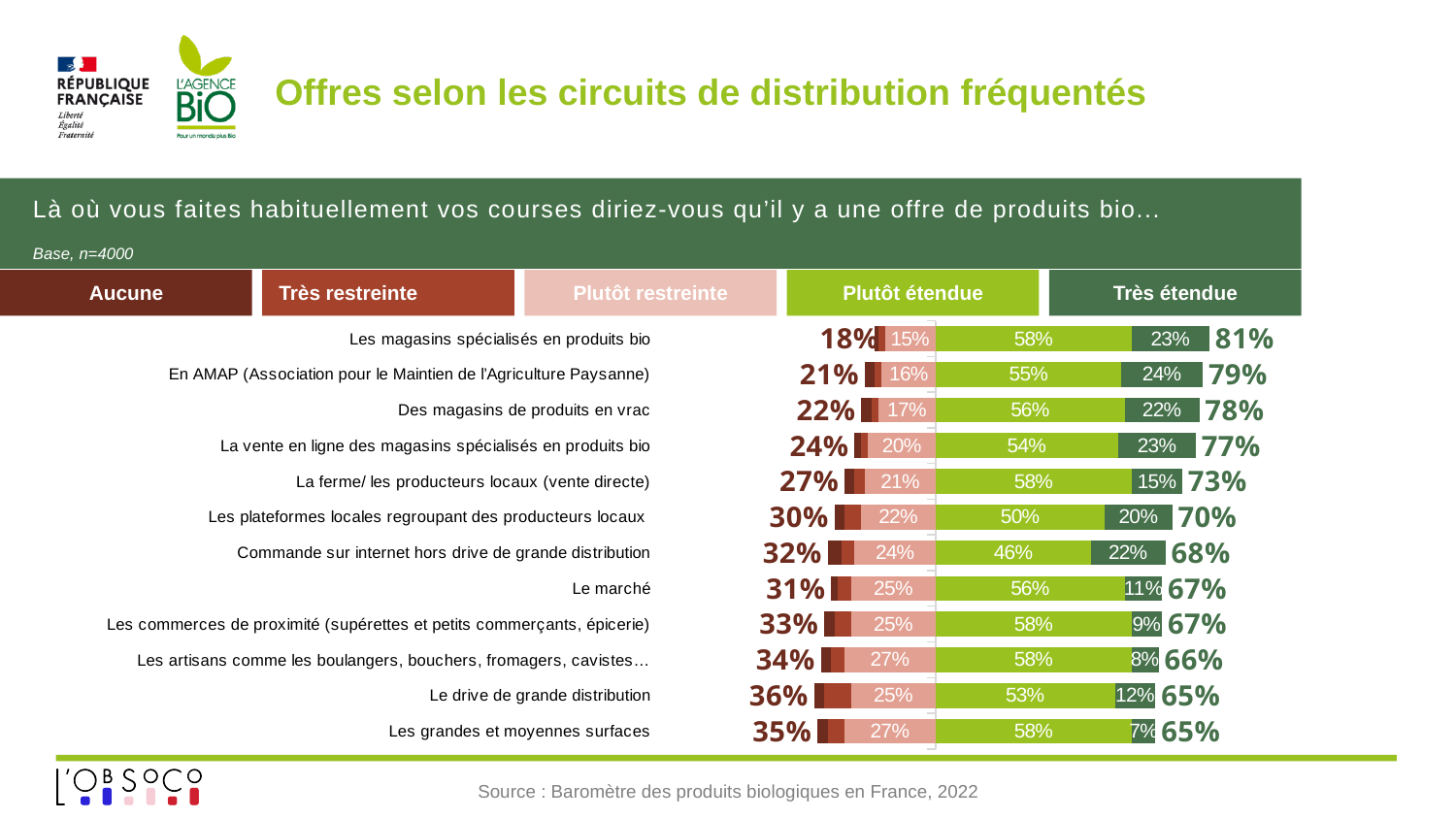
How many distribution channels (categories) are listed in the chart? 12 What is the 'Plutôt restreinte' value for 'Le drive de grande distribution'? 25% What is the 'Très étendue' value for 'En AMAP (Association pour le Maintien de l'Agriculture Paysanne)'? 24% What is the title of the slide? Offres selon les circuits de distribution fréquentés Which category has the highest combined 'étendue' total shown at the right end of the bars? Les magasins spécialisés en produits bio (81%) What kind of chart is shown on the slide? Stacked bar chart What is the combined total of 'Plutôt étendue' and 'Très étendue' for 'La ferme/ les producteurs locaux (vente directe)'? 73% What is the difference in 'Plutôt étendue' between 'Les magasins spécialisés en produits bio' and 'Commande sur internet hors drive de grande distribution'? 12 percentage points Which has the larger 'Plutôt restreinte' value: 'Les artisans comme les boulangers, bouchers, fromagers, cavistes…' or 'La ferme/ les producteurs locaux (vente directe)'? Les artisans comme les boulangers, bouchers, fromagers, cavistes… How many series does the legend list? 5 Which category has the lowest 'Très étendue' value? Les grandes et moyennes surfaces (7%) What is the 'Plutôt étendue' value for 'Le marché'? 56%